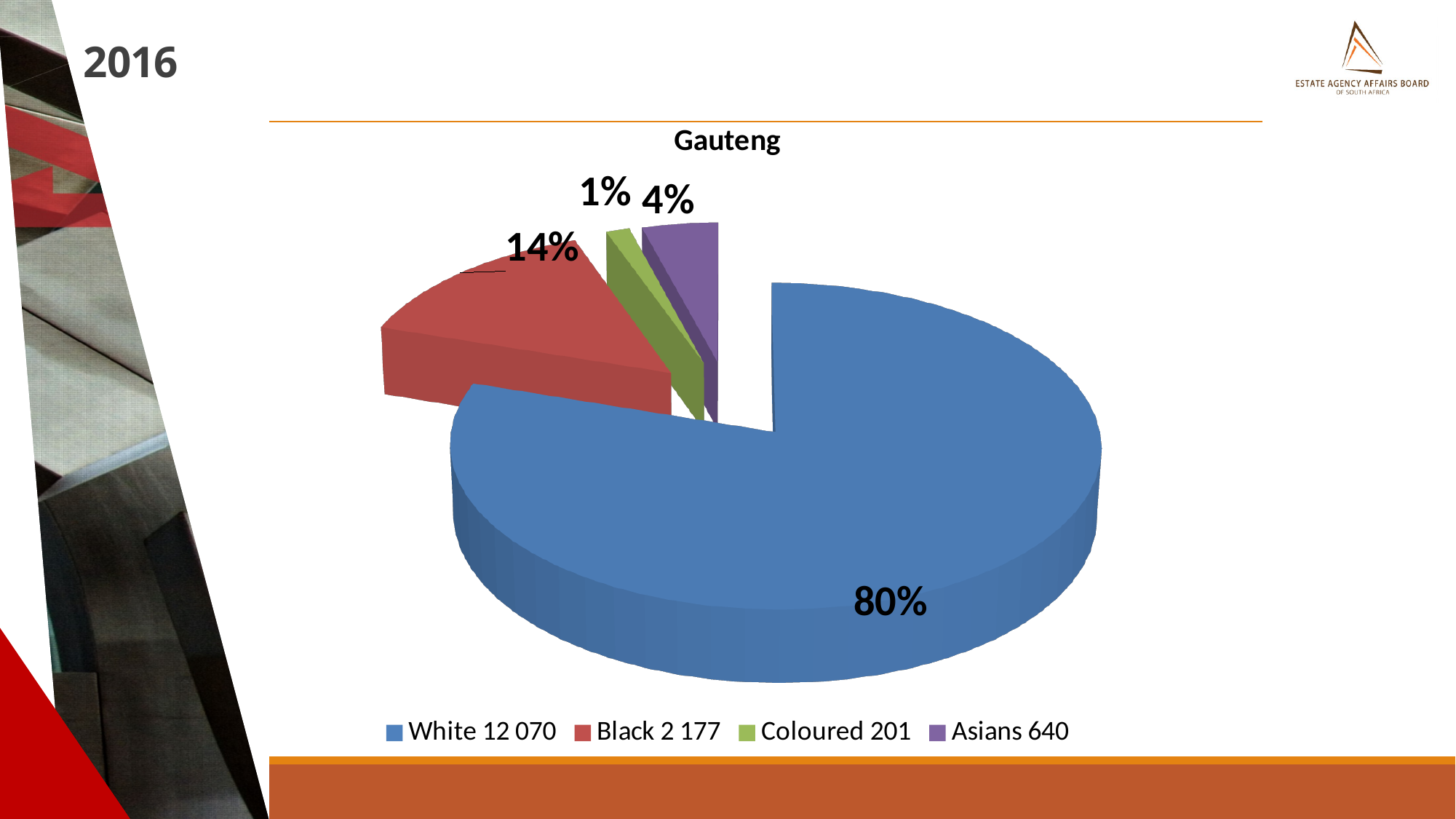
What colour is the slice for Asians? Purple Which category has the largest slice of the pie? White What is the difference in percentage points between the White slice and the Black slice? 66 What percentage share does the Coloured slice have? 1% What is the title of the chart? Gauteng Which category has the smallest slice of the pie? Coloured Which is larger, the Black slice or the Asians slice? Black What percentage share does the Black slice have? 14% How many categories does the pie chart show? 4 What kind of chart is shown on the slide? Pie chart What percentage share does the Asians slice have? 4%